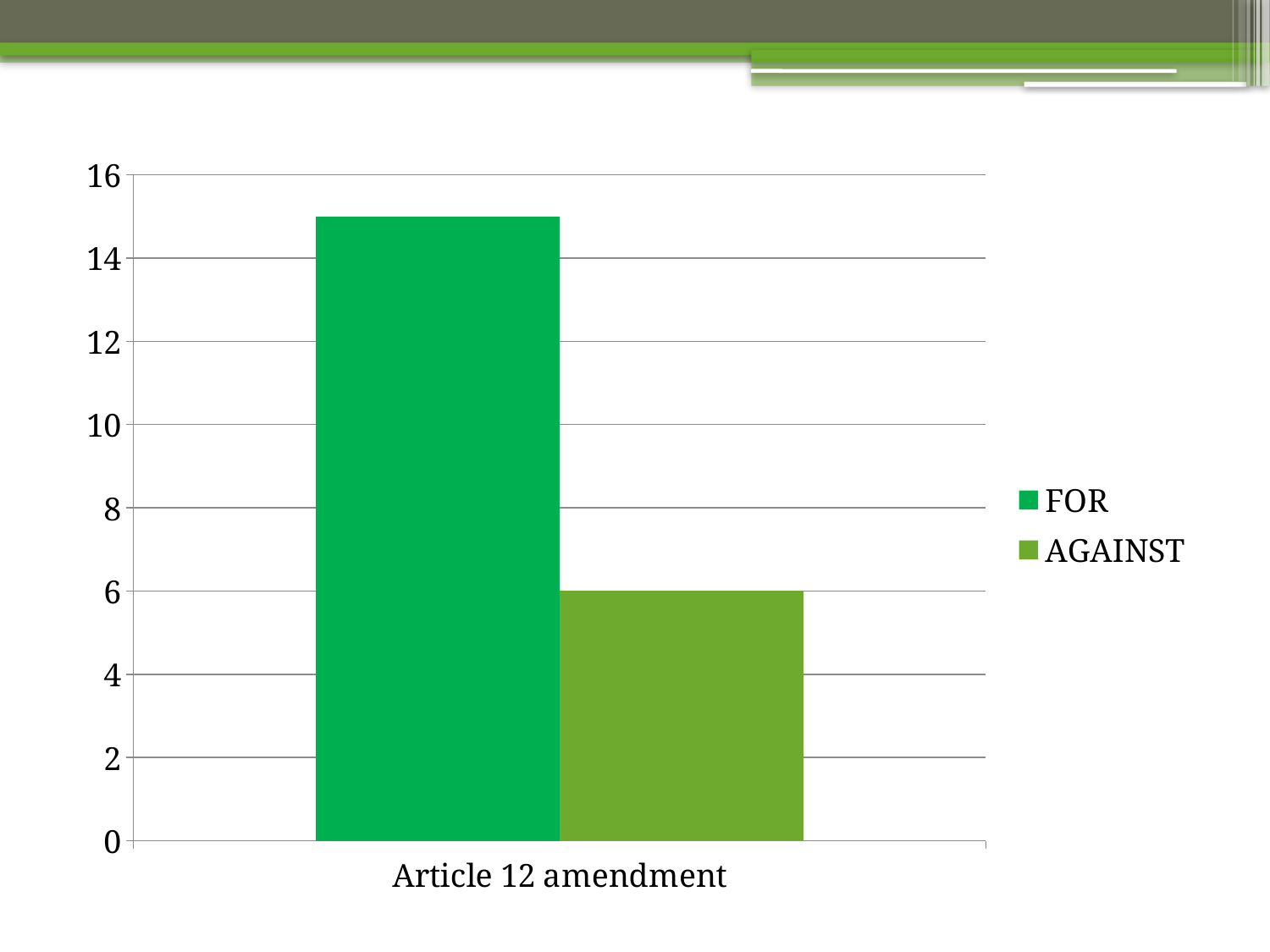
Is the value of the AGAINST bar greater or less than 10? less Which is larger for Article 12 amendment, FOR or AGAINST? FOR What are the two entries listed in the legend? FOR and AGAINST How many series does the legend list? 2 Is the value of the FOR bar greater or less than 14? greater What is the category label shown on the x axis? Article 12 amendment Which series has the lowest bar? AGAINST How many categories are shown on the x axis? 1 What kind of chart is shown on the slide? bar chart What is the value of the AGAINST bar for Article 12 amendment? 6 Which series has the highest bar? FOR Is the value of the FOR bar greater or less than 16? less